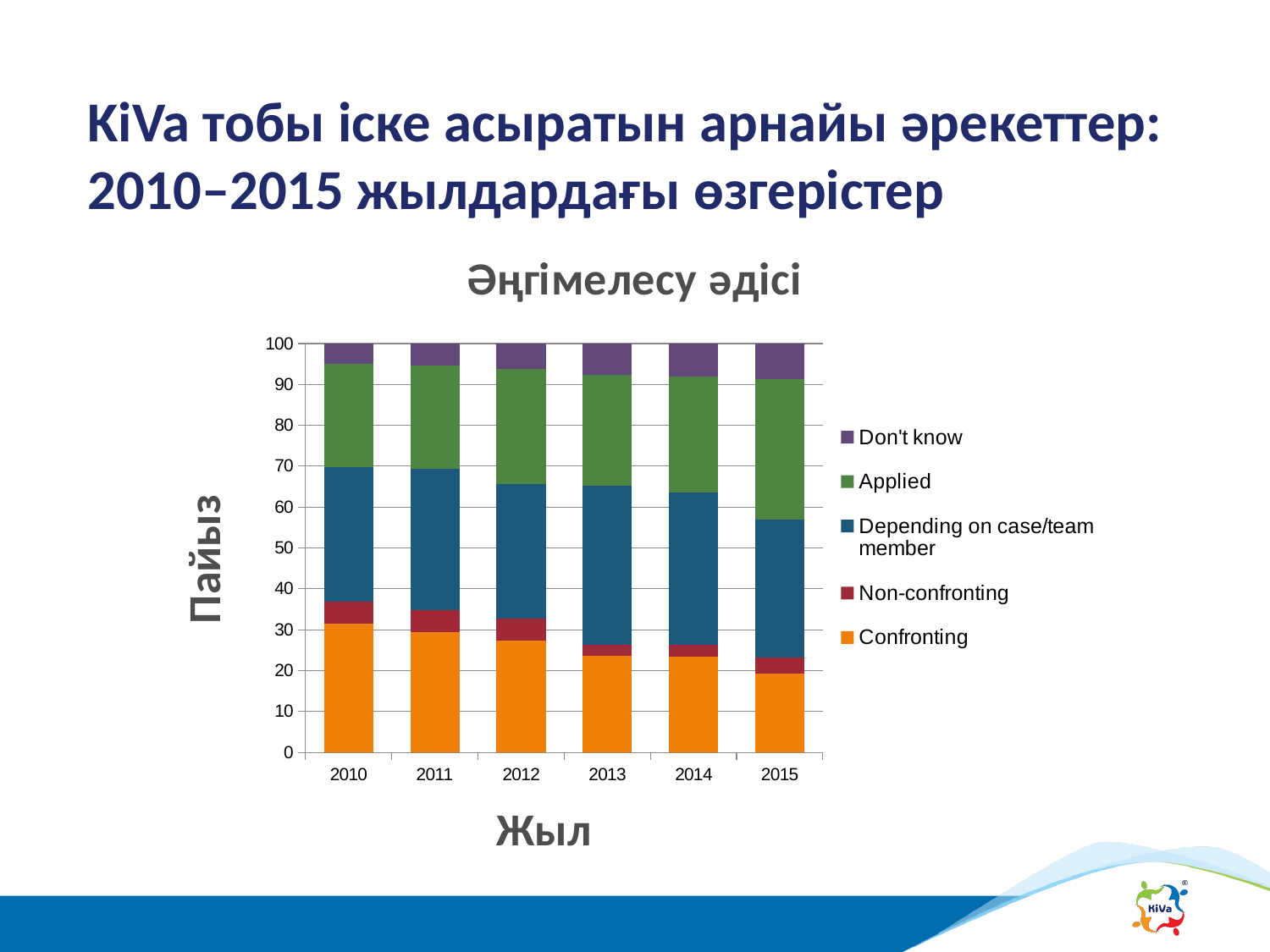
In which year is the Confronting segment the largest? 2010 In which year is the Confronting segment the smallest? 2015 Does the Applied segment rise or fall from 2010 to 2015? rise How many series does the chart's legend list? 5 How many years are shown on the x axis of the chart? 6 What kind of chart is shown on the slide? stacked bar chart What is the title of the chart? Әңгімелесу әдісі Does the Confronting segment rise or fall from 2010 to 2015? fall Is the Confronting value for 2013 greater or less than 30? less What is the total height of the stacked bar for 2010? 100 Which year has the larger Applied segment, 2010 or 2015? 2015 Which series is shown in orange at the bottom of each stacked bar? Confronting